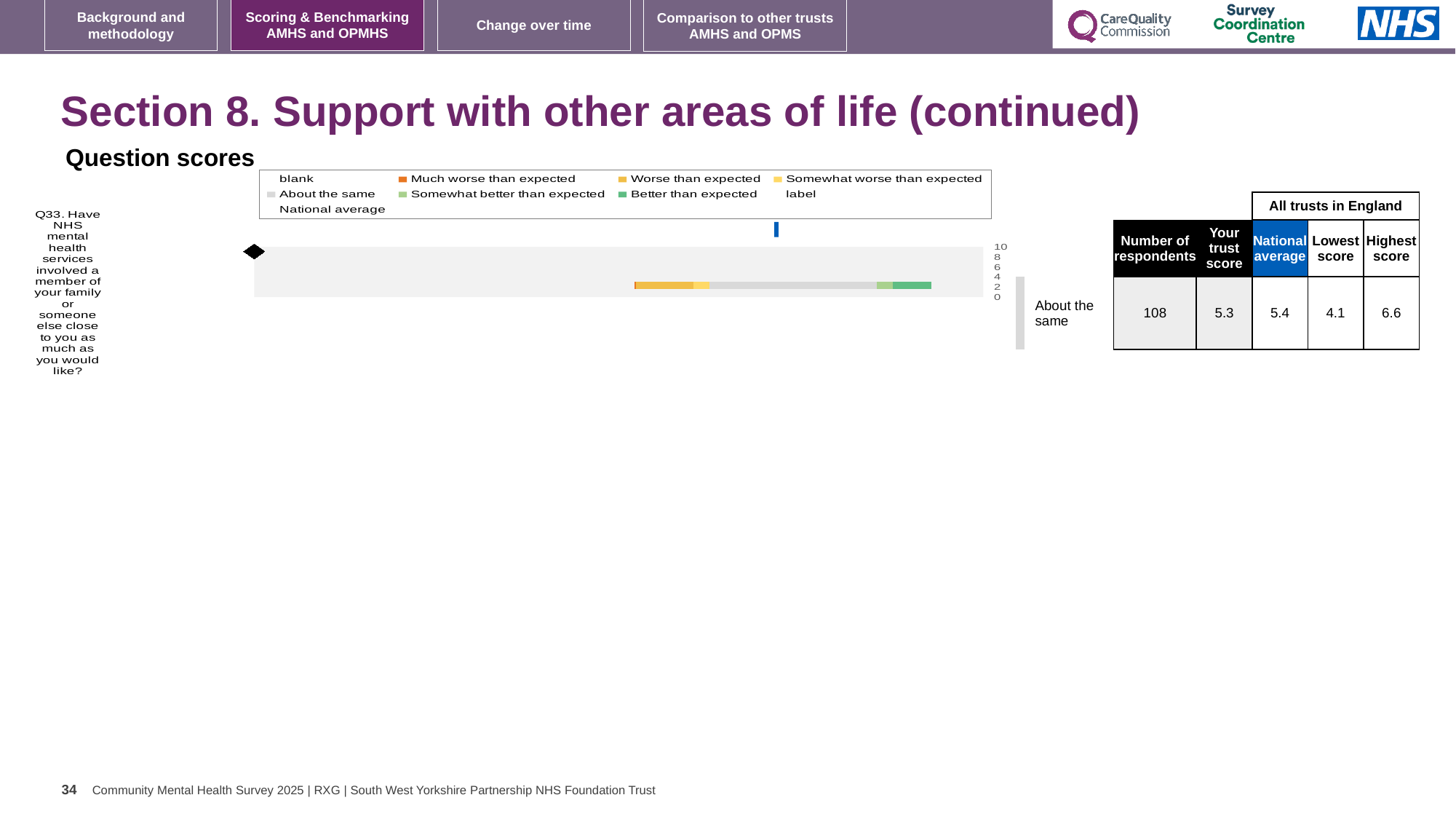
In the table beside the chart, what is the Lowest score among all trusts in England for Q33? 4.1 How many entries does the legend of the Question scores chart list? 9 How many questions (categories) are plotted in the Question scores chart? 1 What is the difference between the Highest score and the Lowest score for Q33? 2.5 In the table beside the chart, how many respondents answered Q33? 108 Which question is plotted in the Question scores chart? Q33. Have NHS mental health services involved a member of your family or someone else close to you as much as you would like? In the table beside the chart, what is the Highest score among all trusts in England for Q33? 6.6 In the table beside the chart, what is the 'Your trust score' for Q33? 5.3 What kind of chart is shown under 'Question scores'? bar chart Which is larger for Q33, the trust score or the National average? National average In the table beside the chart, what is the National average for Q33? 5.4 What benchmark label is shown for Q33 next to the chart? About the same